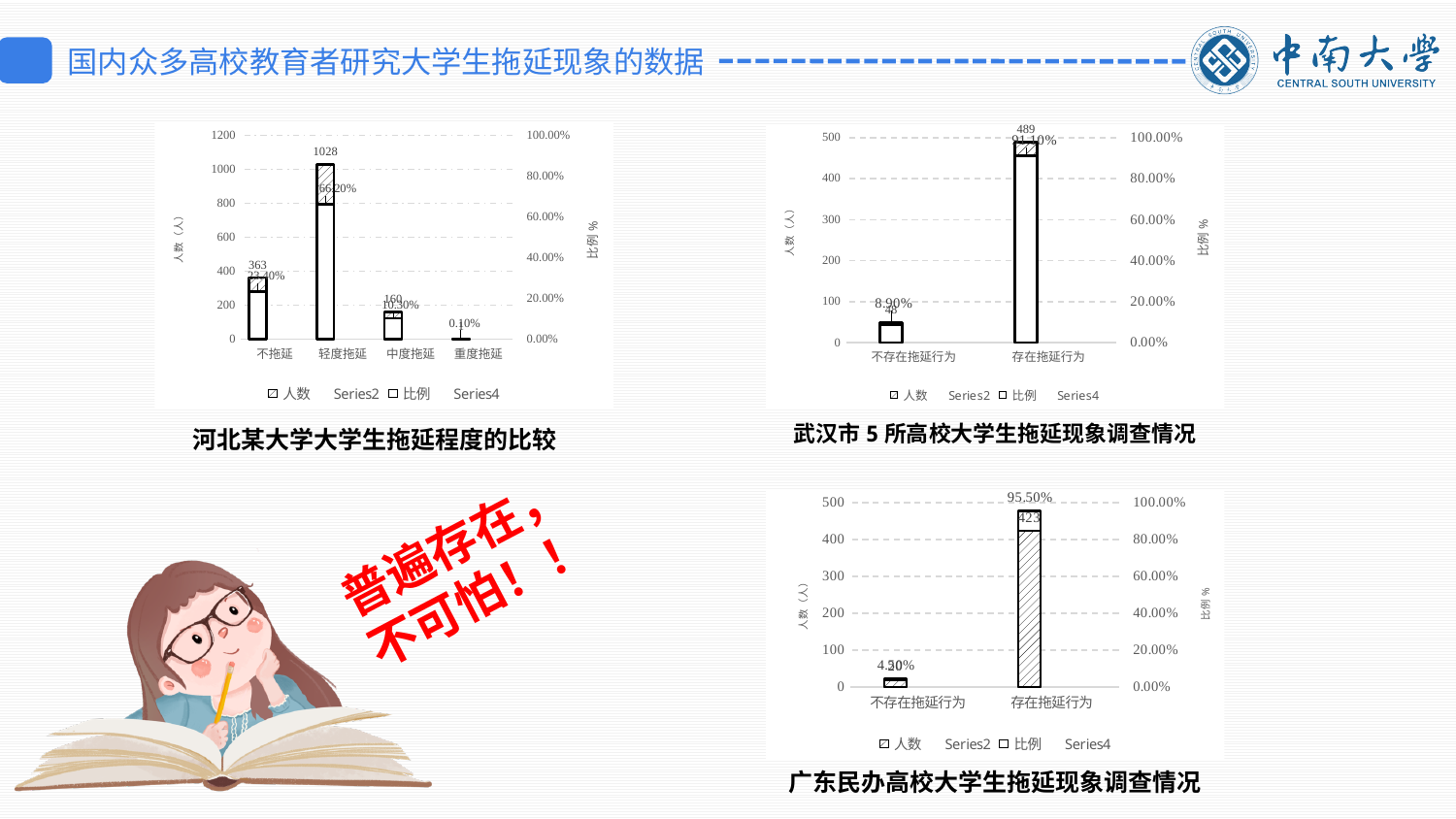
In the chart titled 河北某大学大学生拖延程度的比较, which category has the lowest 人数? 重度拖延 What kind of chart is the chart titled 广东民办高校大学生拖延现象调查情况? bar chart In the chart titled 河北某大学大学生拖延程度的比较, what is the 比例 value for 轻度拖延? 66.20% In the chart titled 广东民办高校大学生拖延现象调查情况, what is the 人数 value for 存在拖延行为? 423 In the chart titled 河北某大学大学生拖延程度的比较, how many categories are shown on the x axis? 4 In the chart titled 广东民办高校大学生拖延现象调查情况, is the 人数 value for 不存在拖延行为 greater or less than 100? less In the chart titled 武汉市5所高校大学生拖延现象调查情况, what is the 比例 value for 不存在拖延行为? 8.90% In the chart titled 河北某大学大学生拖延程度的比较, what is the 人数 value for 轻度拖延? 1028 In the chart titled 河北某大学大学生拖延程度的比较, what is the 人数 value for 不拖延? 363 In the chart titled 河北某大学大学生拖延程度的比较, what is the difference in 人数 between 轻度拖延 and 不拖延? 665 In the chart titled 武汉市5所高校大学生拖延现象调查情况, what is the 人数 value for 存在拖延行为? 489 In the chart titled 河北某大学大学生拖延程度的比较, which category has the highest 人数? 轻度拖延